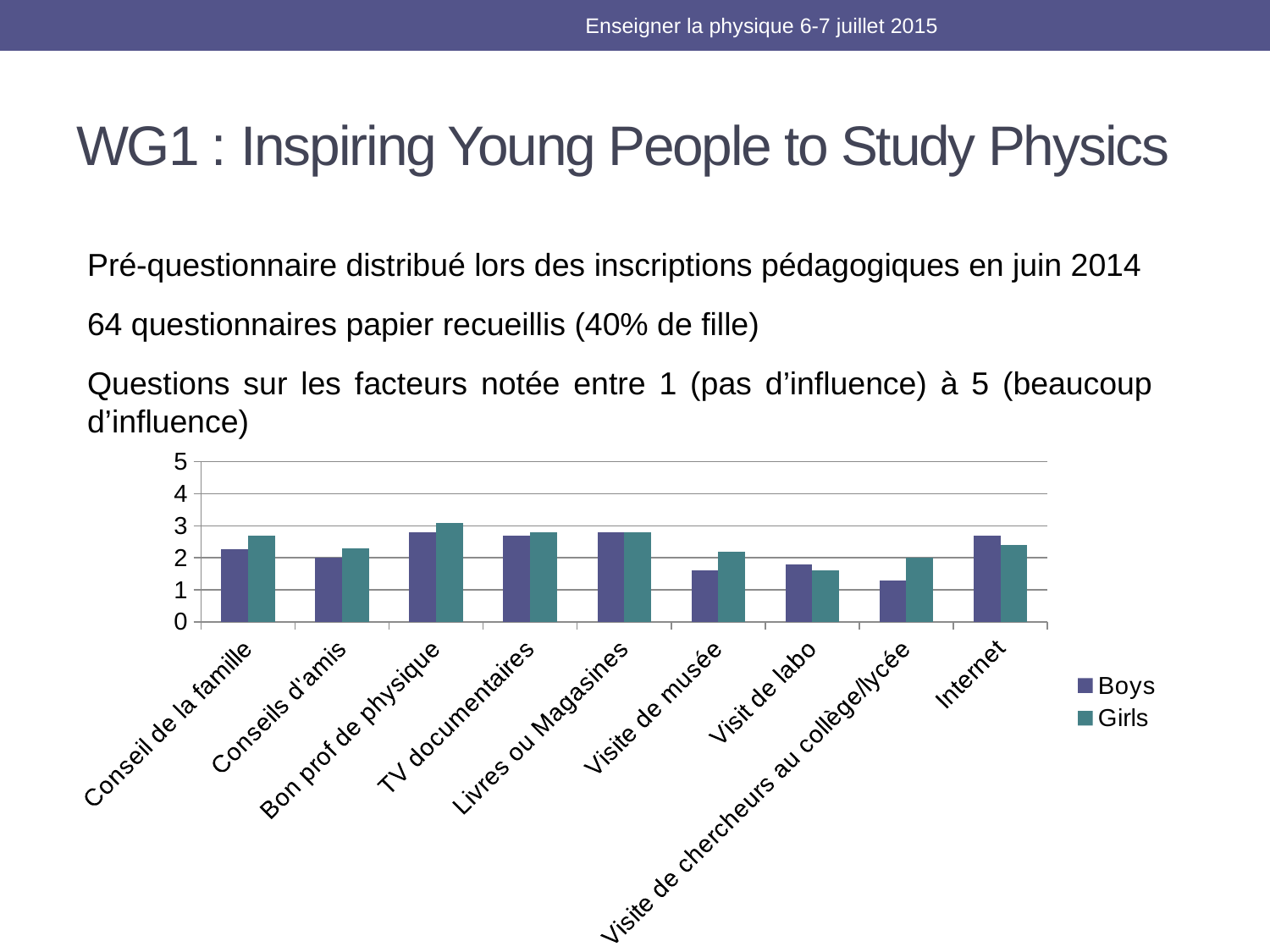
What are the two series named in the chart legend? Boys and Girls How many series does the chart legend list? 2 What kind of chart is shown on the slide? bar chart Which category has the highest value for Girls? Bon prof de physique Is the Boys value for Visite de chercheurs au collège/lycée greater or less than 2? less For Visite de chercheurs au collège/lycée, which is larger: the Boys value or the Girls value? Girls Is the Boys value for Visite de musée greater or less than 2? less For Conseil de la famille, which is larger: the Boys value or the Girls value? Girls Which category has the lowest value for Boys? Visite de chercheurs au collège/lycée For Internet, which is larger: the Boys value or the Girls value? Boys How many categories (factors) are shown on the x axis of the chart? 9